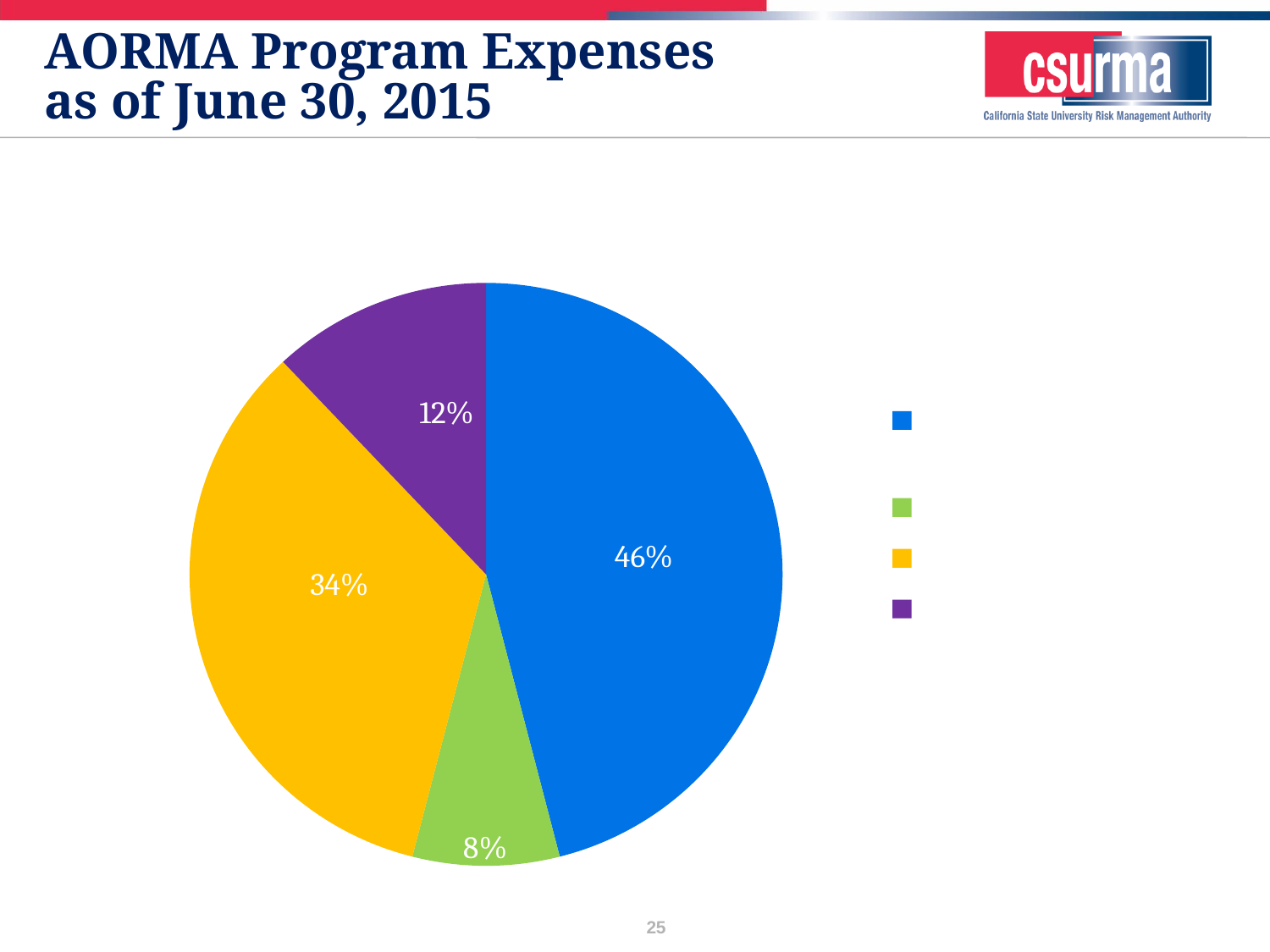
Which colour slice is the smallest in the pie chart? green What percentage is shown on the green slice of the pie chart? 8% Which is larger, the purple slice or the green slice? purple Which colour slice is the largest in the pie chart? blue What is the title of the slide containing the pie chart? AORMA Program Expenses as of June 30, 2015 What is the difference in percentage points between the blue slice and the yellow slice? 12 What percentage is shown on the yellow slice of the pie chart? 34% How many slices does the pie chart have? 4 What percentage is shown on the purple slice of the pie chart? 12% What kind of chart is shown on the slide? pie chart What percentage is shown on the blue slice of the pie chart? 46% How many entries does the legend of the pie chart list? 4